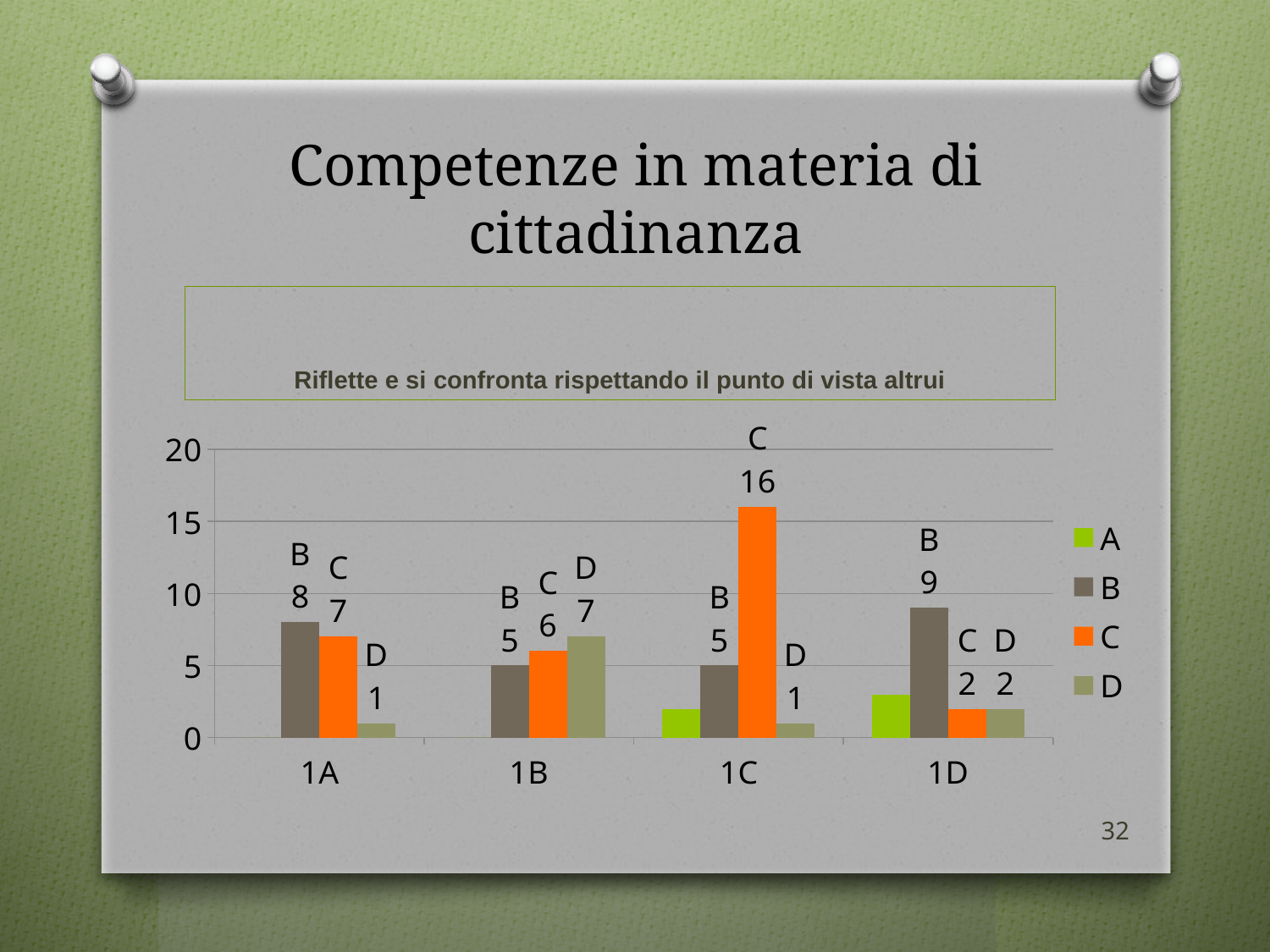
What is the difference between the value of series C for 1C and the value of series C for 1D? 14 Which is larger: series B for 1A or series B for 1D? Series B for 1D What is the value of series C for category 1A? 7 Is the value of series A for category 1D greater or less than 5? less How many series does the legend list? 4 What kind of chart is shown on the slide? Bar chart What is the value of series D for category 1B? 7 Which category has the lowest value for series B? 1B and 1C (both 5) How many categories are shown on the x axis? 4 What is the value of series C for category 1C? 16 Which category has the highest value for series C? 1C What is the value of series B for category 1D? 9